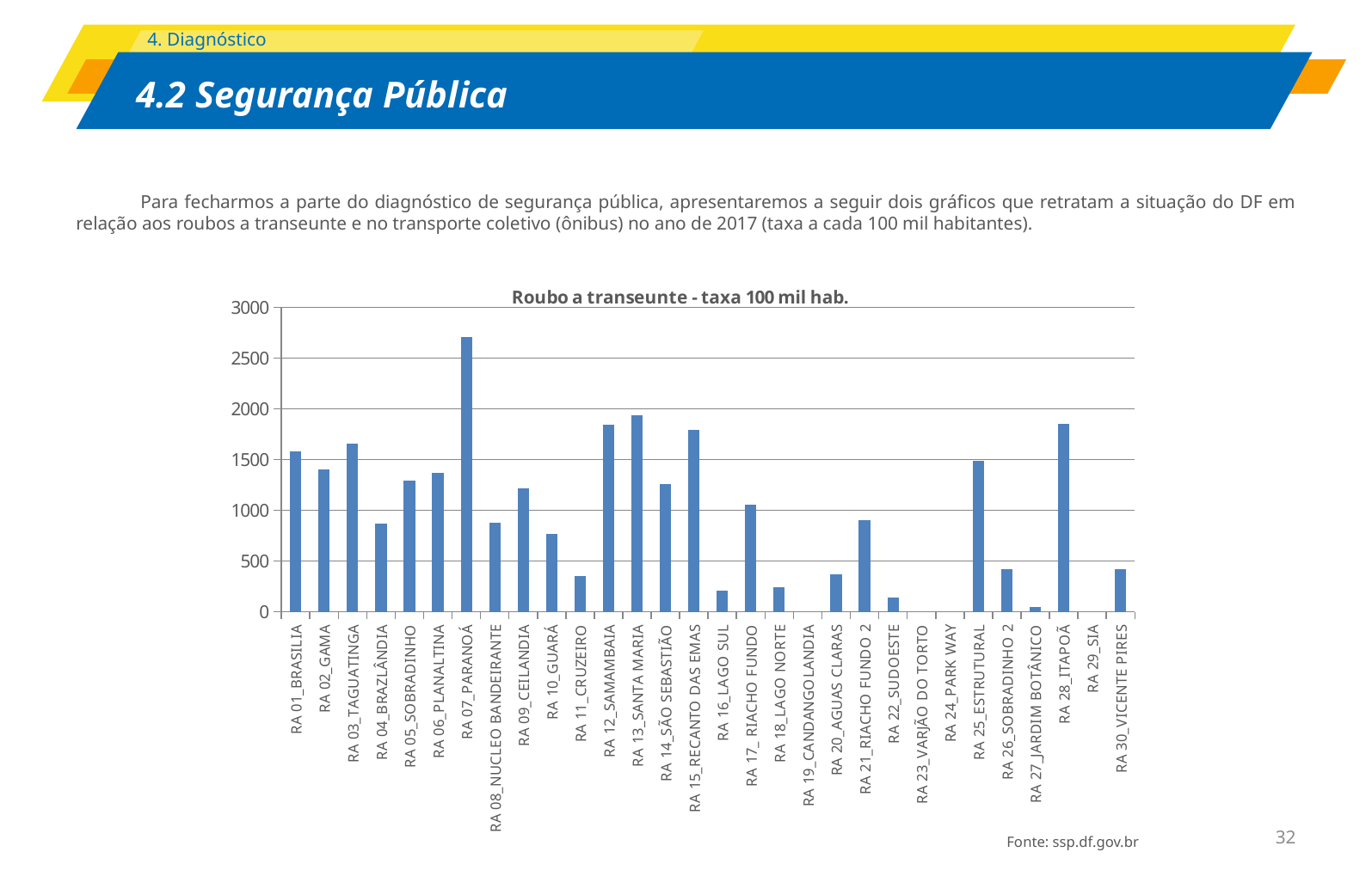
Is the value for RA 04_BRAZLÂNDIA greater or less than 1000? less Is the value for RA 28_ITAPOÃ greater or less than 1500? greater Is the value for RA 03_TAGUATINGA greater or less than 1500? greater Which has a larger value, RA 09_CEILANDIA or RA 10_GUARÁ? RA 09_CEILANDIA What is the title of the chart? Roubo a transeunte - taxa 100 mil hab. What type of chart is shown on the slide? Bar chart Which has a larger value, RA 20_AGUAS CLARAS or RA 22_SUDOESTE? RA 20_AGUAS CLARAS How many categories (regions) are shown on the x axis of the chart? 30 Which category has the highest value in the chart? RA 07_PARANOÁ